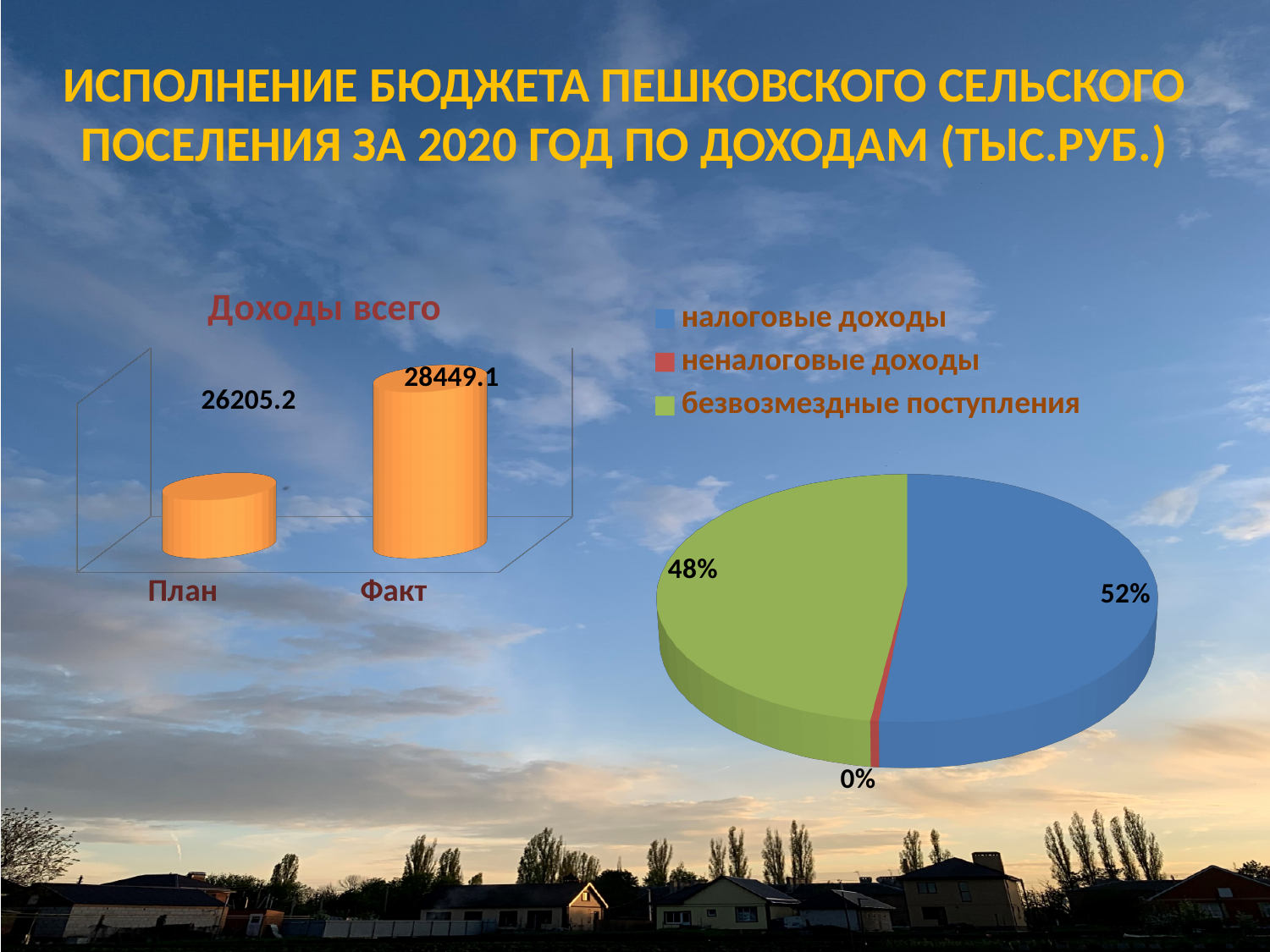
What kind of chart is the 'Доходы всего' chart on the left? Bar chart In the 'Доходы всего' chart, how many categories are shown? 2 In the pie chart on the right, what share is shown for безвозмездные поступления? 48% In the pie chart on the right, what share is shown for налоговые доходы? 52% In the 'Доходы всего' chart, what is the value for План? 26205.2 In the 'Доходы всего' chart, which category has the higher value, План or Факт? Факт In the pie chart on the right, which category has the smallest share? неналоговые доходы In the pie chart on the right, which category has the largest share? налоговые доходы In the 'Доходы всего' chart, what is the difference between Факт and План? 2243.9 In the 'Доходы всего' chart, what is the value for Факт? 28449.1 How many entries does the legend of the pie chart on the right list? 3 In the pie chart on the right, what share is shown for неналоговые доходы? 0%